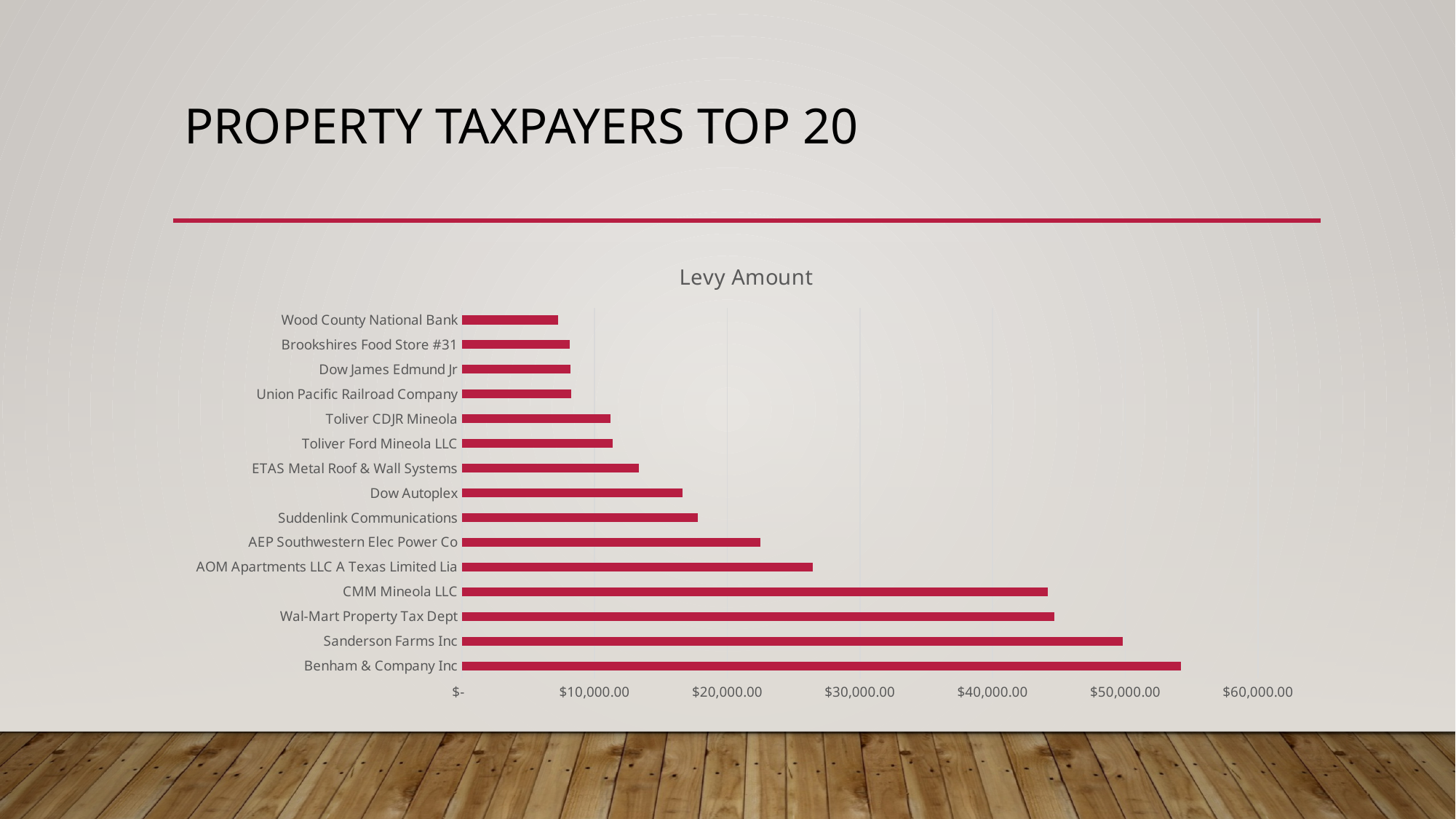
Which taxpayer has the lowest levy amount? Wood County National Bank Is the levy amount for AEP Southwestern Elec Power Co greater or less than $20,000.00? greater What kind of chart is shown on the slide? bar chart Which taxpayer has the highest levy amount? Benham & Company Inc Which has a larger levy amount, Sanderson Farms Inc or CMM Mineola LLC? Sanderson Farms Inc Which has a larger levy amount, Suddenlink Communications or ETAS Metal Roof & Wall Systems? Suddenlink Communications Is the levy amount for Benham & Company Inc greater or less than $50,000.00? greater Is the levy amount for AOM Apartments LLC A Texas Limited Lia greater or less than $30,000.00? less What is the title of the chart on the slide? Levy Amount How many taxpayers (categories) are plotted in the Levy Amount chart? 15